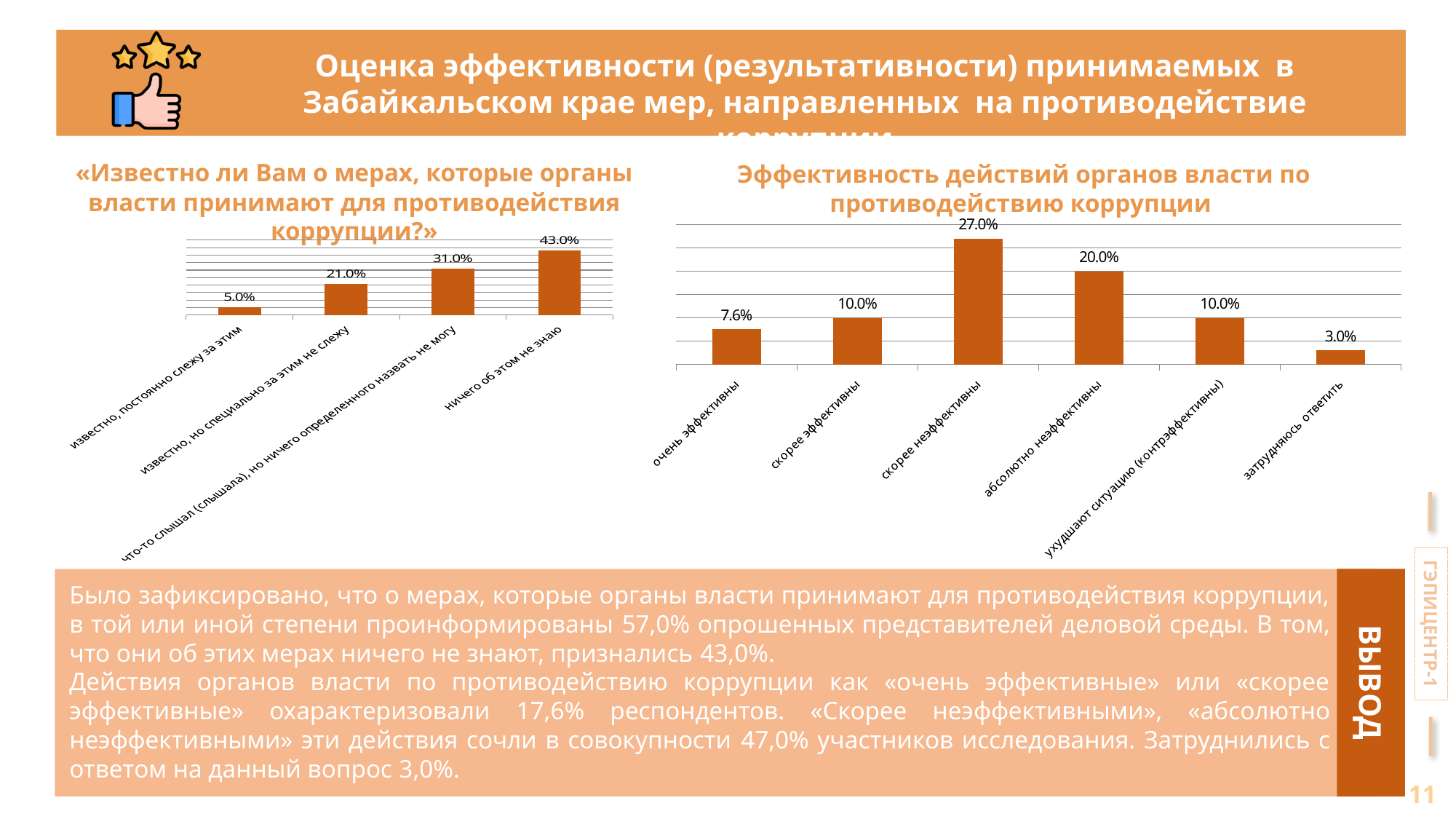
In the left chart («Известно ли Вам о мерах...»), what is the difference between «что-то слышал (слышала), но ничего определенного назвать не могу» and «известно, но специально за этим не слежу»? 10.0% In the right chart (Эффективность действий органов власти по противодействию коррупции), which category has the highest value? скорее неэффективны In the left chart («Известно ли Вам о мерах...»), which category has the highest value? ничего об этом не знаю What type of chart is the right chart (Эффективность действий органов власти по противодействию коррупции)? bar chart How many categories are shown in the left chart («Известно ли Вам о мерах...»)? 4 In the right chart (Эффективность действий органов власти по противодействию коррупции), what is the value for «очень эффективны»? 7.6% In the right chart (Эффективность действий органов власти по противодействию коррупции), which category has the lowest value? затрудняюсь ответить In the right chart (Эффективность действий органов власти по противодействию коррупции), what is the value for «абсолютно неэффективны»? 20.0% How many categories are shown in the right chart (Эффективность действий органов власти по противодействию коррупции)? 6 In the left chart («Известно ли Вам о мерах...»), what is the value for «ничего об этом не знаю»? 43.0% In the right chart (Эффективность действий органов власти по противодействию коррупции), which is larger: «скорее неэффективны» or «абсолютно неэффективны»? скорее неэффективны In the left chart («Известно ли Вам о мерах...»), what is the value for «известно, постоянно слежу за этим»? 5.0%